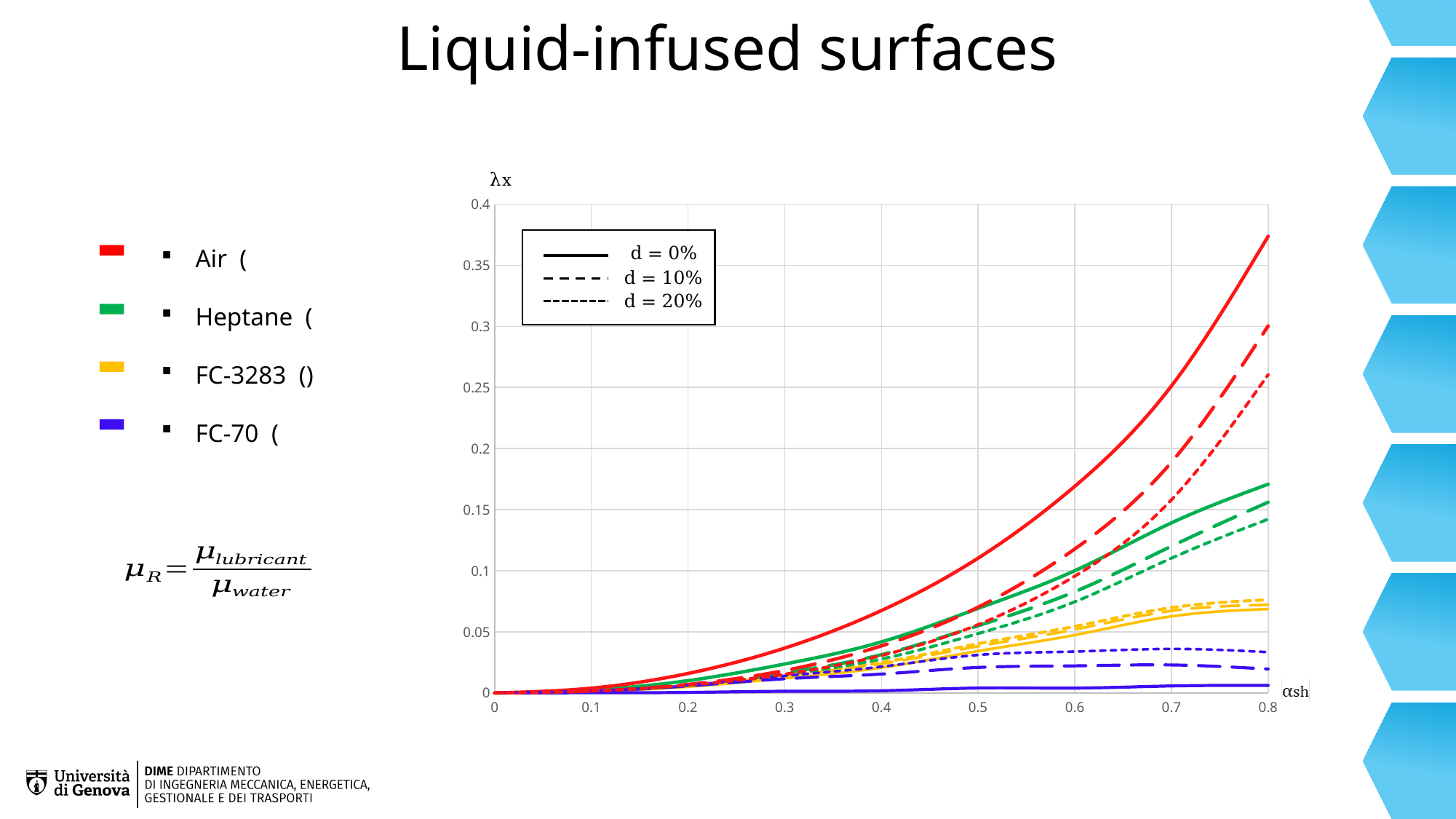
What kind of chart is shown on the slide? line chart Is the λx value of the solid Heptane (d = 0%) curve at αsh = 0.8 greater or less than 0.15? greater How does λx for the solid Air curve change as αsh increases from 0 to 0.8? It rises How many line styles (values of d) does the legend inside the chart list? 3 Is the λx value of the solid FC-70 (d = 0%) curve at αsh = 0.8 greater or less than 0.05? less Is the λx value of the solid Air (d = 0%) curve at αsh = 0.8 greater or less than 0.35? greater What is the label on the horizontal axis of the chart? αsh At αsh = 0.8, which is larger for d = 0%: the λx of Air or of Heptane? Air Which lubricant has the highest λx at αsh = 0.8 for d = 0%? Air Which lubricant has the lowest λx at αsh = 0.8 for d = 0%? FC-70 How many lubricants are listed in the colour legend to the left of the chart? 4